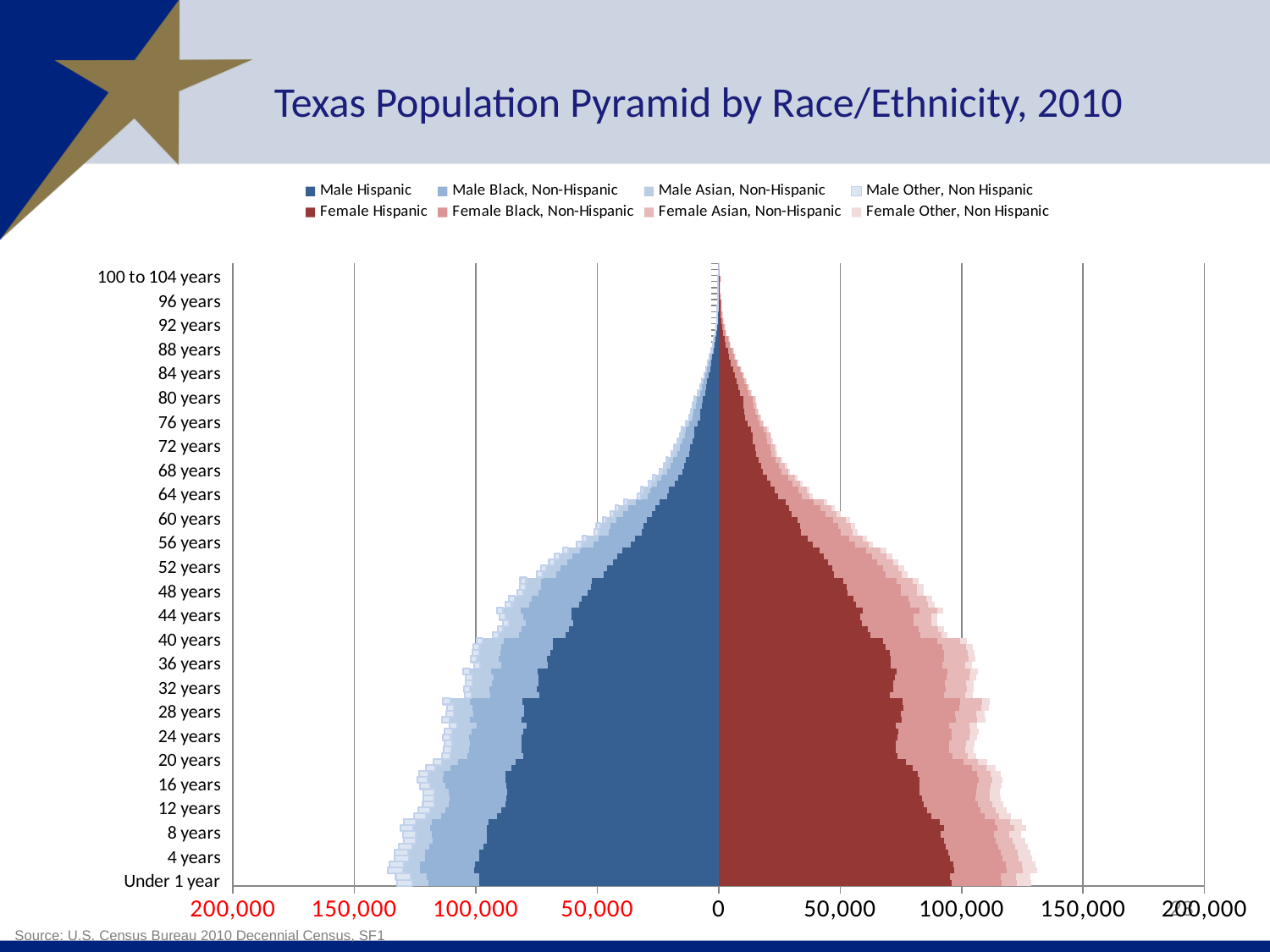
Is the total male population for the 80 years age group greater or less than 50,000? less Moving from the youngest age groups at the bottom to the oldest at the top, do the bar lengths generally increase or decrease? Decrease Is the total male population for the 68 years age group greater or less than 50,000? less Is the total female population for the 28 years age group greater or less than 100,000? greater How many series does the legend list? 8 Which legend entry is shown in the darkest red colour? Female Hispanic What is the title of the chart? Texas Population Pyramid by Race/Ethnicity, 2010 At 80 years, which side of the pyramid is larger, male or female? Female Which age group has a larger total population, Under 1 year or 60 years? Under 1 year What kind of chart is shown on the slide? Bar chart (population pyramid)